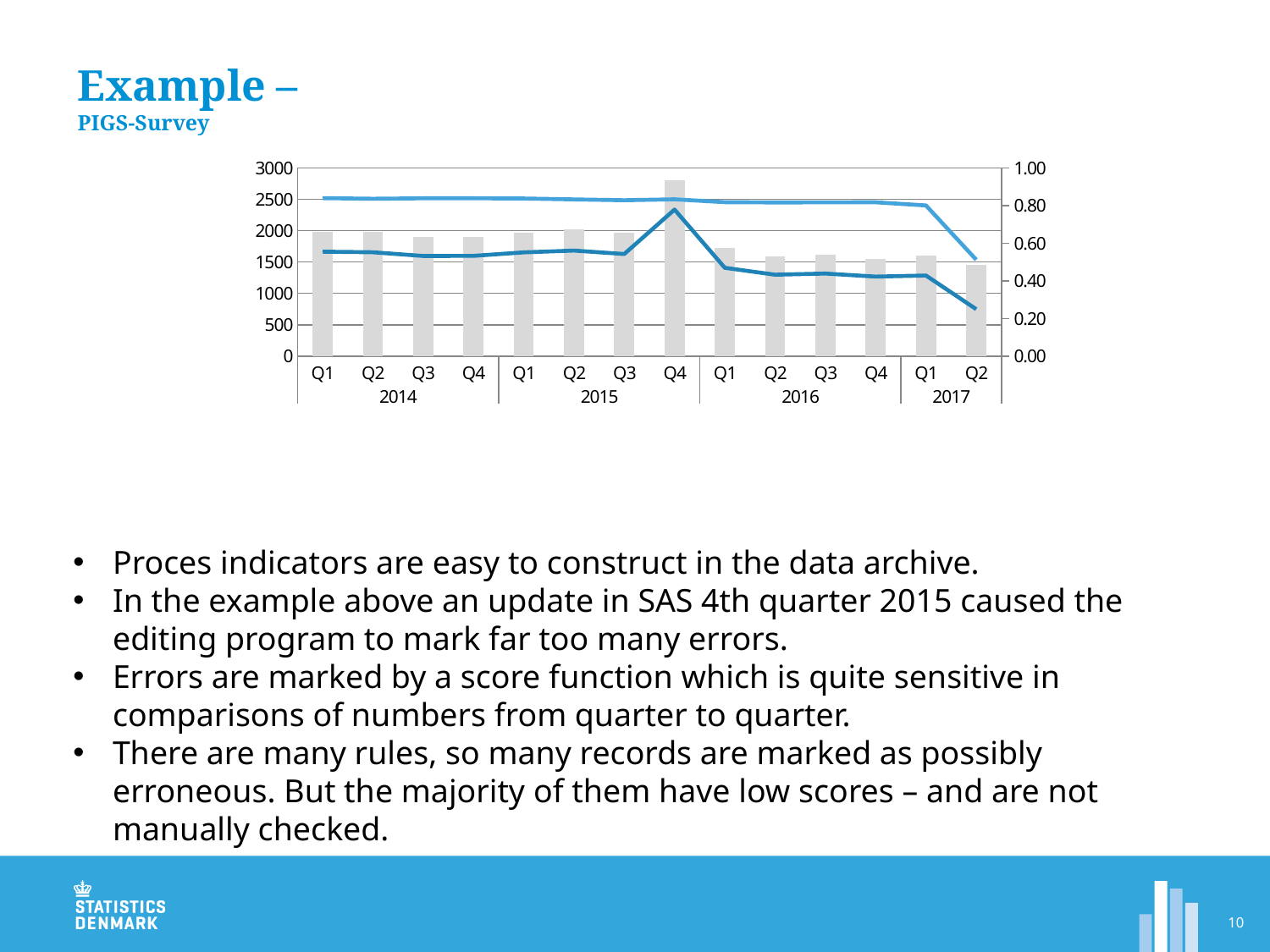
Is the bar for Q1 2016 greater or less than 2000 on the left axis? less Which bar is taller, Q1 2014 or Q2 2017? Q1 2014 How many quarterly bars are plotted in the chart? 14 Is the value of the darker blue line at Q2 2017 greater or less than 0.40 on the right axis? less What kind of chart is shown on the slide? A combined bar and line chart Is the bar for Q4 2015 greater or less than 2500 on the left axis? greater Do the two lines rise or fall overall from Q1 2014 to Q2 2017? fall Which quarter has the highest bar in the chart? Q4 2015 Which quarter has the lowest bar in the chart? Q2 2017 Which bar is taller, Q4 2015 or Q1 2016? Q4 2015 What is the maximum value shown on the right-hand axis of the chart? 1.00